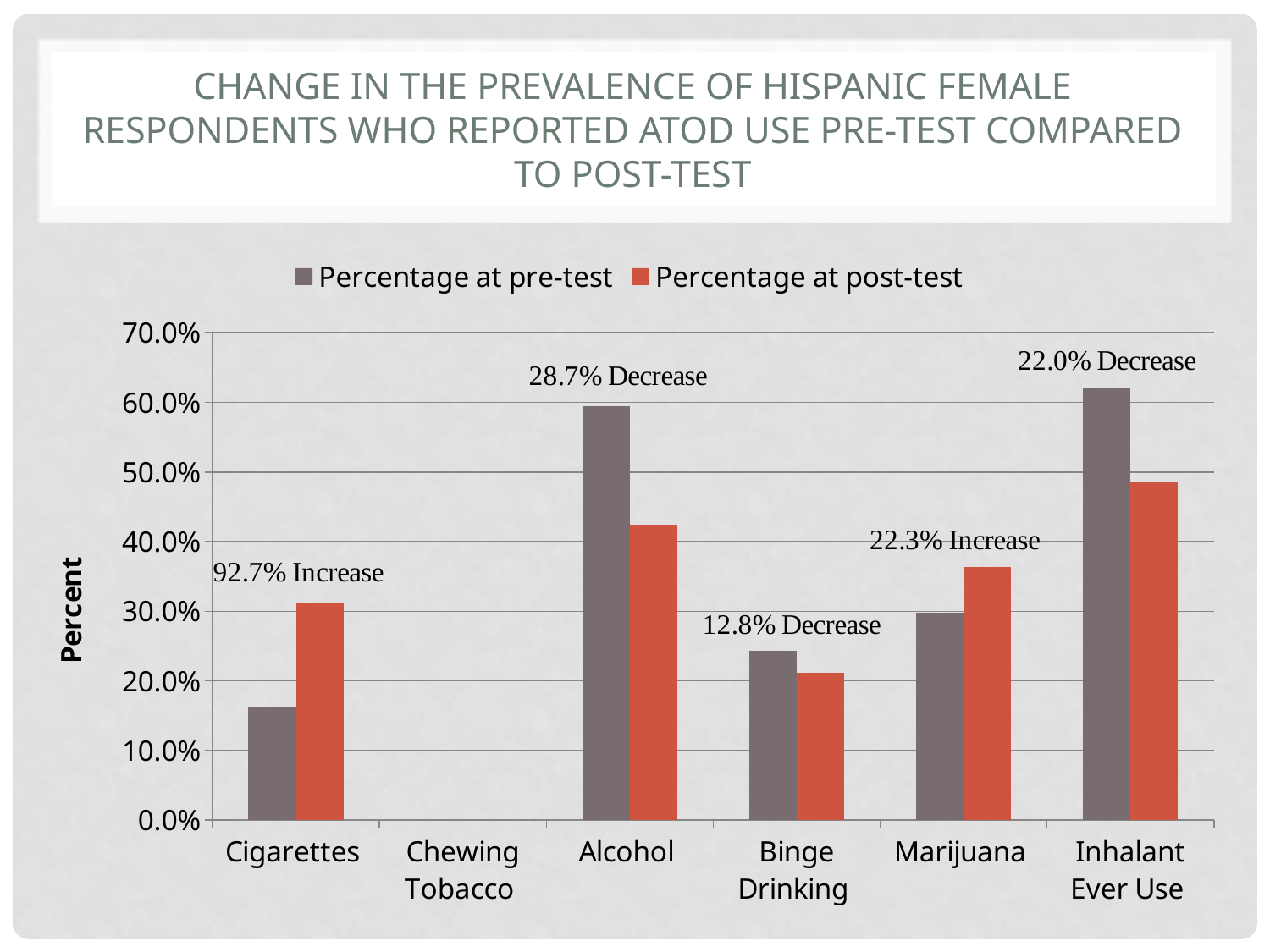
How many series does the legend list? 2 What type of chart is shown on the slide? bar chart Which category has the highest Percentage at post-test? Inhalant Ever Use Is the Percentage at pre-test for Alcohol greater or less than 50.0%? greater How many categories are shown on the x axis? 6 For Marijuana, which is larger: the Percentage at pre-test or the Percentage at post-test? Percentage at post-test Is the Percentage at post-test for Binge Drinking greater or less than 30.0%? less What change is annotated above the Alcohol bars? 28.7% Decrease What change is annotated above the Cigarettes bars? 92.7% Increase What change is annotated above the Inhalant Ever Use bars? 22.0% Decrease What change is annotated above the Marijuana bars? 22.3% Increase What is the label on the vertical axis? Percent